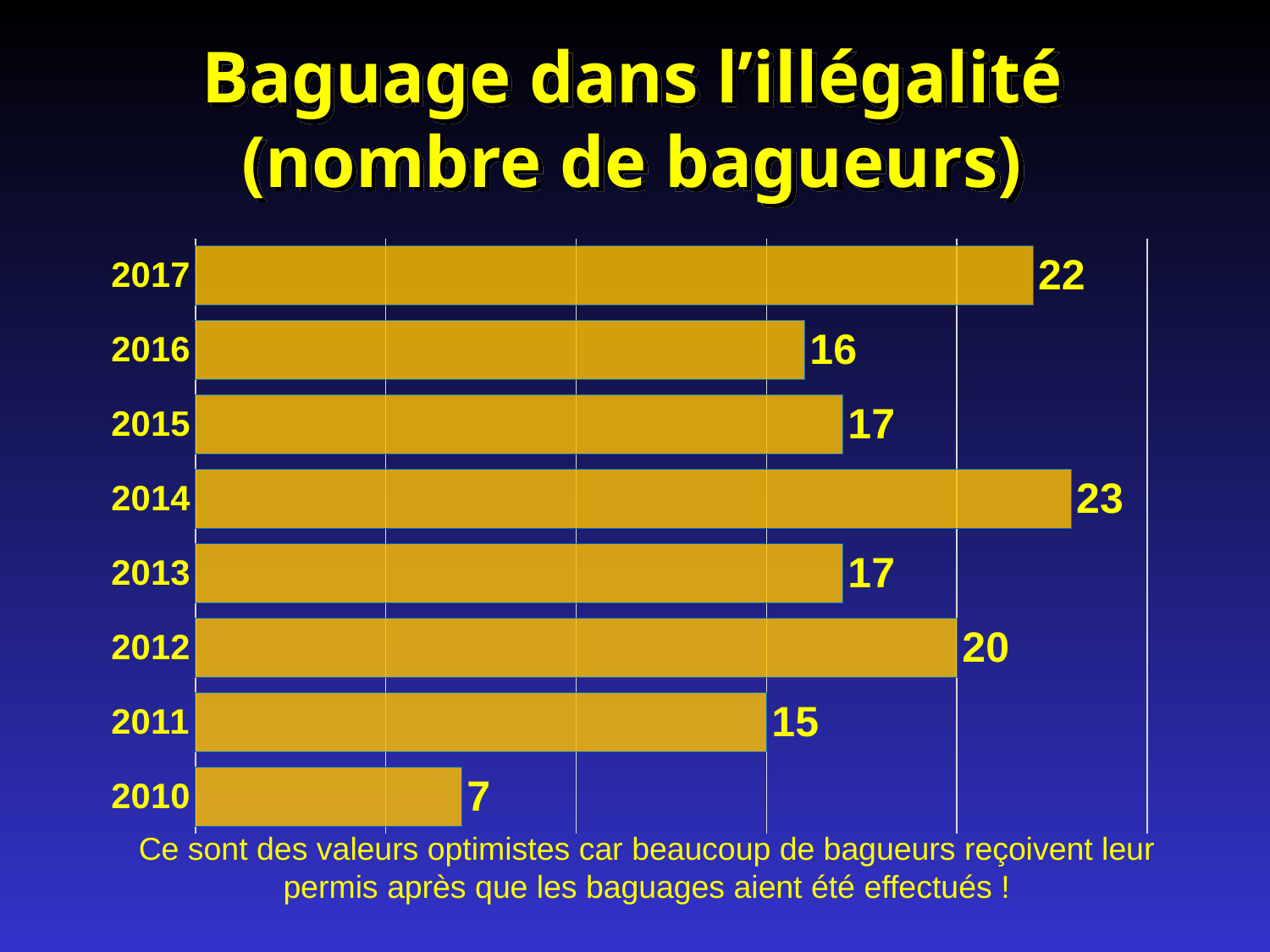
What is the value for 2010? 7 Which year has the lowest value? 2010 Which two years share the same value of 17? 2013 and 2015 How many years are shown in the chart? 8 What is the value for 2012? 20 What is the difference between the values for 2014 and 2010? 16 Which year has the highest value? 2014 What is the title of the chart? Baguage dans l'illégalité (nombre de bagueurs) What kind of chart is shown on the slide? bar chart What is the value for 2017? 22 What is the difference between the values for 2017 and 2016? 6 Which is larger, the value for 2012 or the value for 2011? 2012